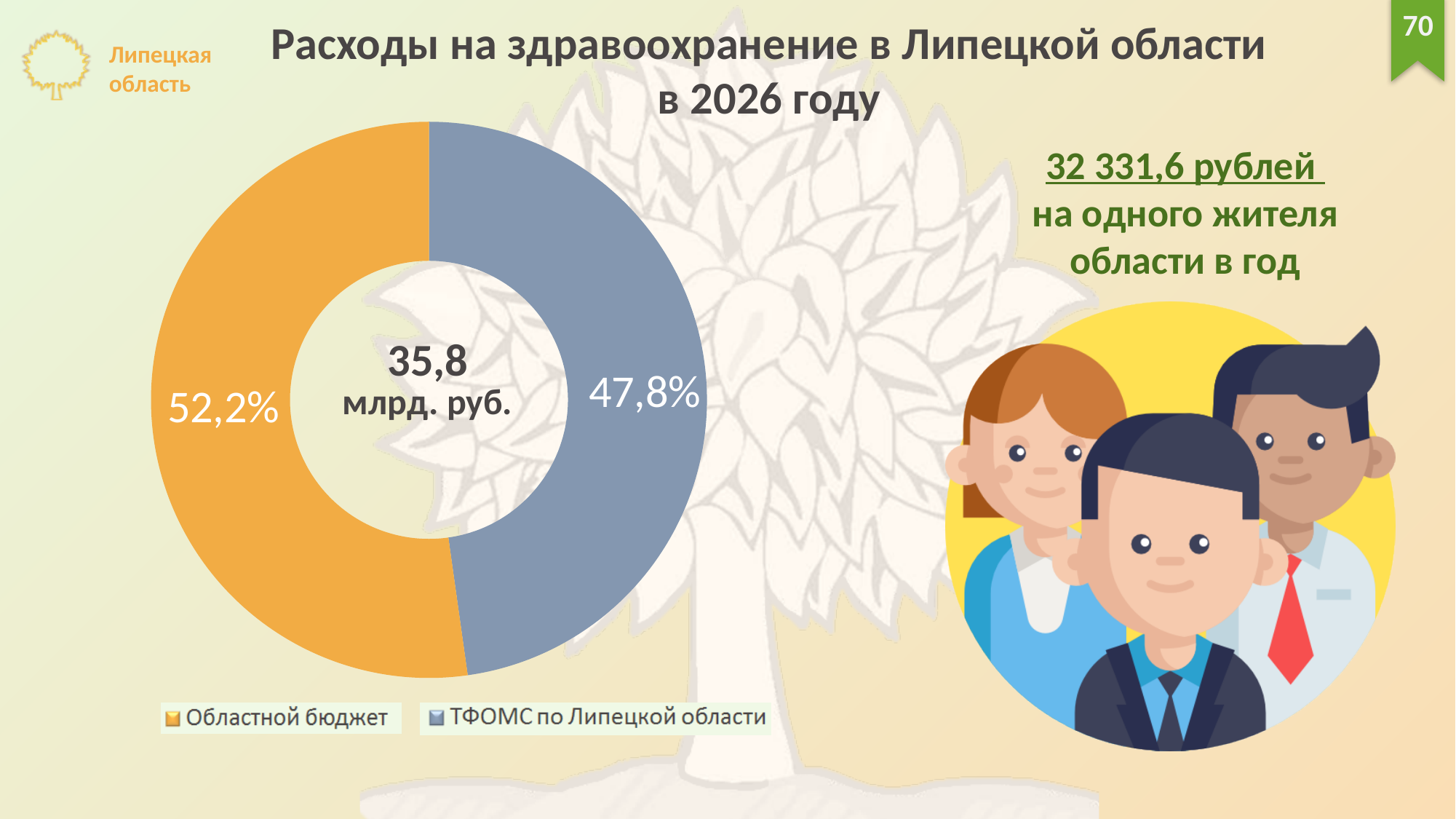
What kind of chart is shown on the slide? doughnut (pie) chart Which source has the larger share of healthcare expenditure? Областной бюджет Which source has the smaller share of healthcare expenditure? ТФОМС по Липецкой области Is the share of Областной бюджет larger or smaller than the share of ТФОМС по Липецкой области? larger What colour represents Областной бюджет in the chart? orange What share of the healthcare expenditure comes from ТФОМС по Липецкой области? 47,8% By how many percentage points does the share of Областной бюджет exceed that of ТФОМС по Липецкой области? 4,4 What total value is shown in the centre of the chart? 35,8 млрд. руб. What is the title of the slide containing the chart? Расходы на здравоохранение в Липецкой области в 2026 году What share of the healthcare expenditure comes from Областной бюджет? 52,2% How many categories does the chart show? 2